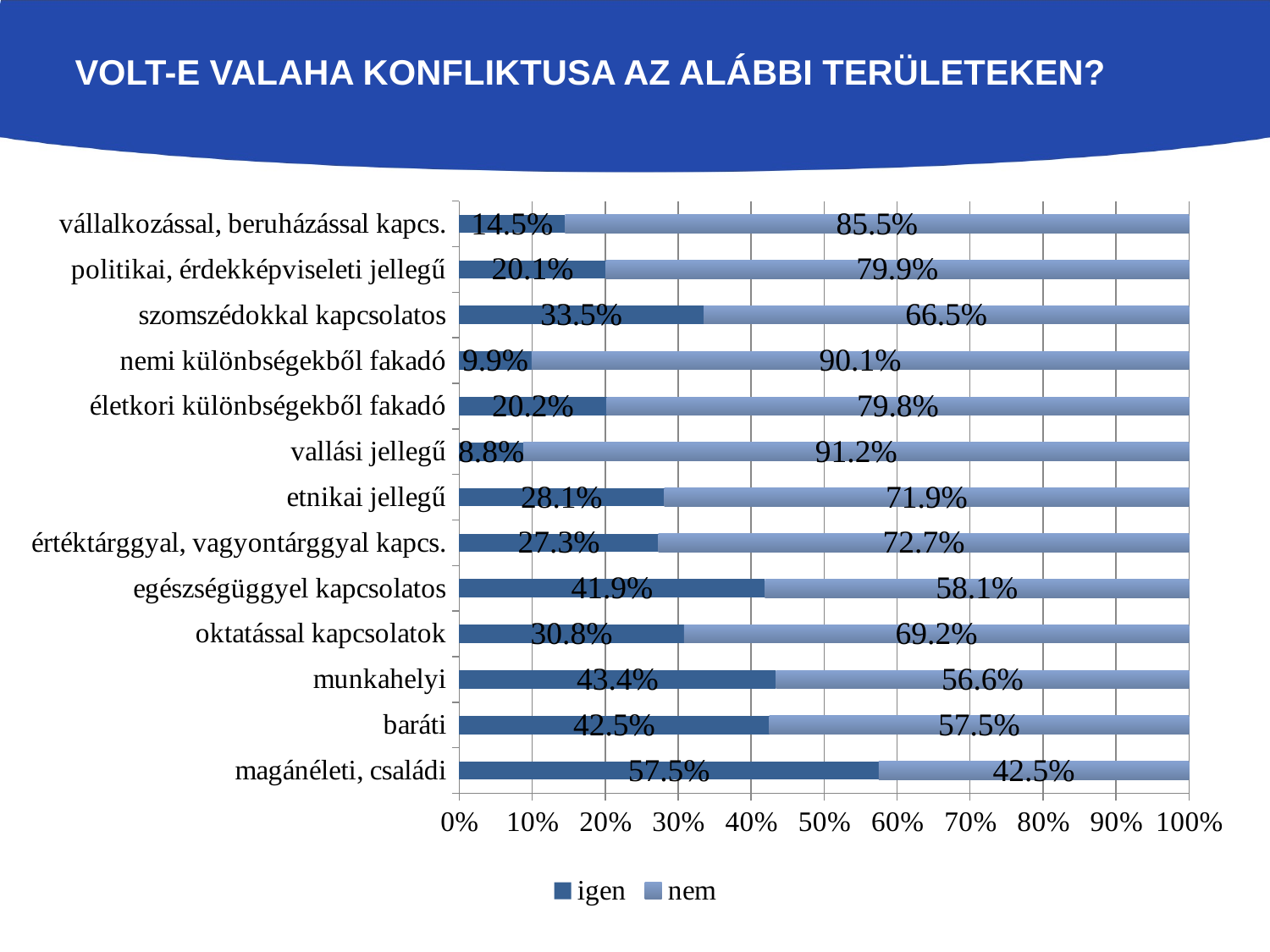
What is the "igen" value for munkahelyi? 43.4% What is the difference between the "igen" values for egészségüggyel kapcsolatos and oktatással kapcsolatok? 11.1% How many series does the legend list? 2 How many categories are shown on the chart? 13 What are the two legend entries of the chart? igen, nem Which category has the highest "igen" value? magánéleti, családi What kind of chart is shown on the slide? stacked bar chart Which has a larger "igen" value, etnikai jellegű or értéktárggyal, vagyontárggyal kapcs.? etnikai jellegű Which category has the lowest "igen" value? vallási jellegű What is the "igen" value for szomszédokkal kapcsolatos? 33.5% What is the total of the stacked bar for baráti? 100% What is the "nem" value for vallási jellegű? 91.2%